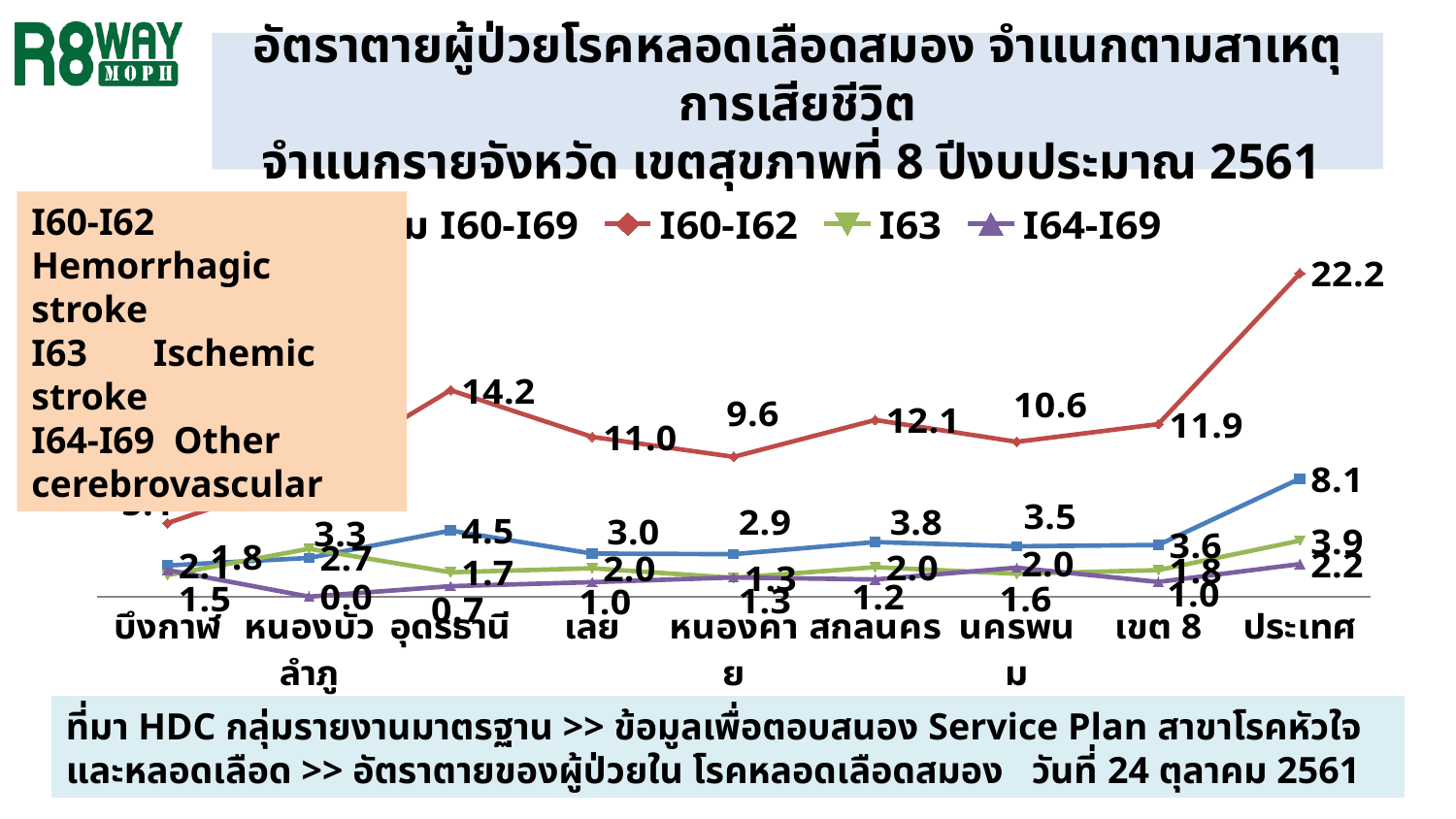
What is the difference between the I60-I62 values for ประเทศ and เขต 8? 10.3 What is the I64-I69 value for หนองบัวลำภู? 0.0 How many categories are shown on the x axis? 9 What is the difference between the I60-I62 values for สกลนคร and หนองคาย? 2.5 What is the I60-I62 value for ประเทศ? 22.2 How many series does the legend list? 4 What kind of chart is shown on the slide? Line chart Which category has the highest I60-I62 value? ประเทศ What is the I63 value for ประเทศ? 3.9 What is the I60-I62 value for อุดรธานี? 14.2 What is the I60-I62 value for หนองคาย? 9.6 Which has the larger I60-I62 value, สกลนคร or นครพนม? สกลนคร